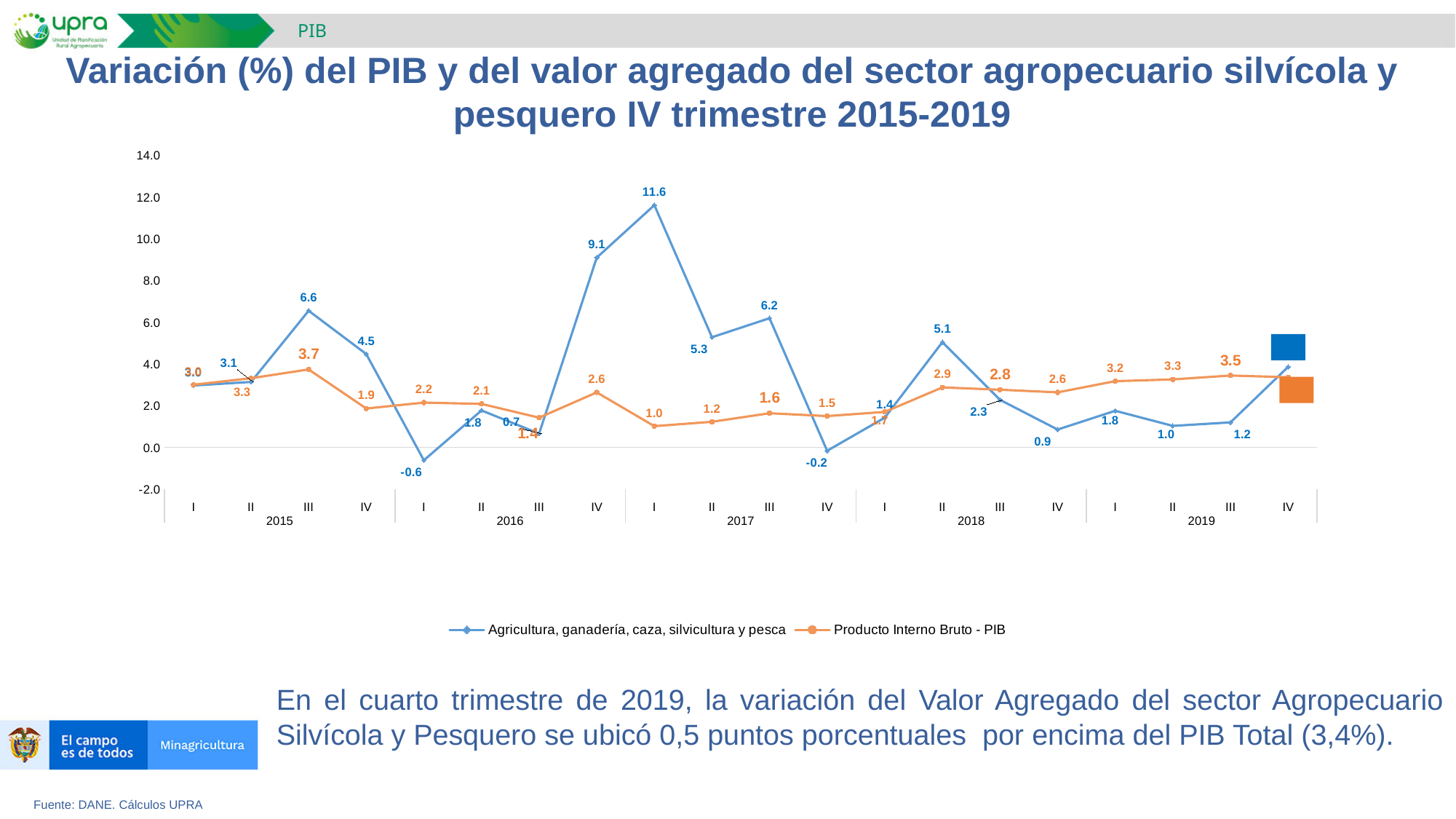
What is the difference between the 'Agricultura, ganadería, caza, silvicultura y pesca' value and the 'Producto Interno Bruto - PIB' value in quarter I of 2017? 10.6 In which quarter does the 'Agricultura, ganadería, caza, silvicultura y pesca' series reach its highest value? I 2017 How many quarters are plotted along the x axis? 20 What is the value of the 'Producto Interno Bruto - PIB' series in quarter III of 2015? 3.7 In quarter II of 2018, which series has the larger value: 'Agricultura, ganadería, caza, silvicultura y pesca' or 'Producto Interno Bruto - PIB'? Agricultura, ganadería, caza, silvicultura y pesca What type of chart is shown on the slide? line chart What is the value of the 'Agricultura, ganadería, caza, silvicultura y pesca' series in quarter III of 2015? 6.6 How many series does the legend list? 2 Does the 'Producto Interno Bruto - PIB' series rise or fall from quarter I to quarter III of 2019? rise Which series is drawn in orange? Producto Interno Bruto - PIB What is the lowest value of the 'Agricultura, ganadería, caza, silvicultura y pesca' series? -0.6 What is the value of the 'Producto Interno Bruto - PIB' series in quarter III of 2019? 3.5